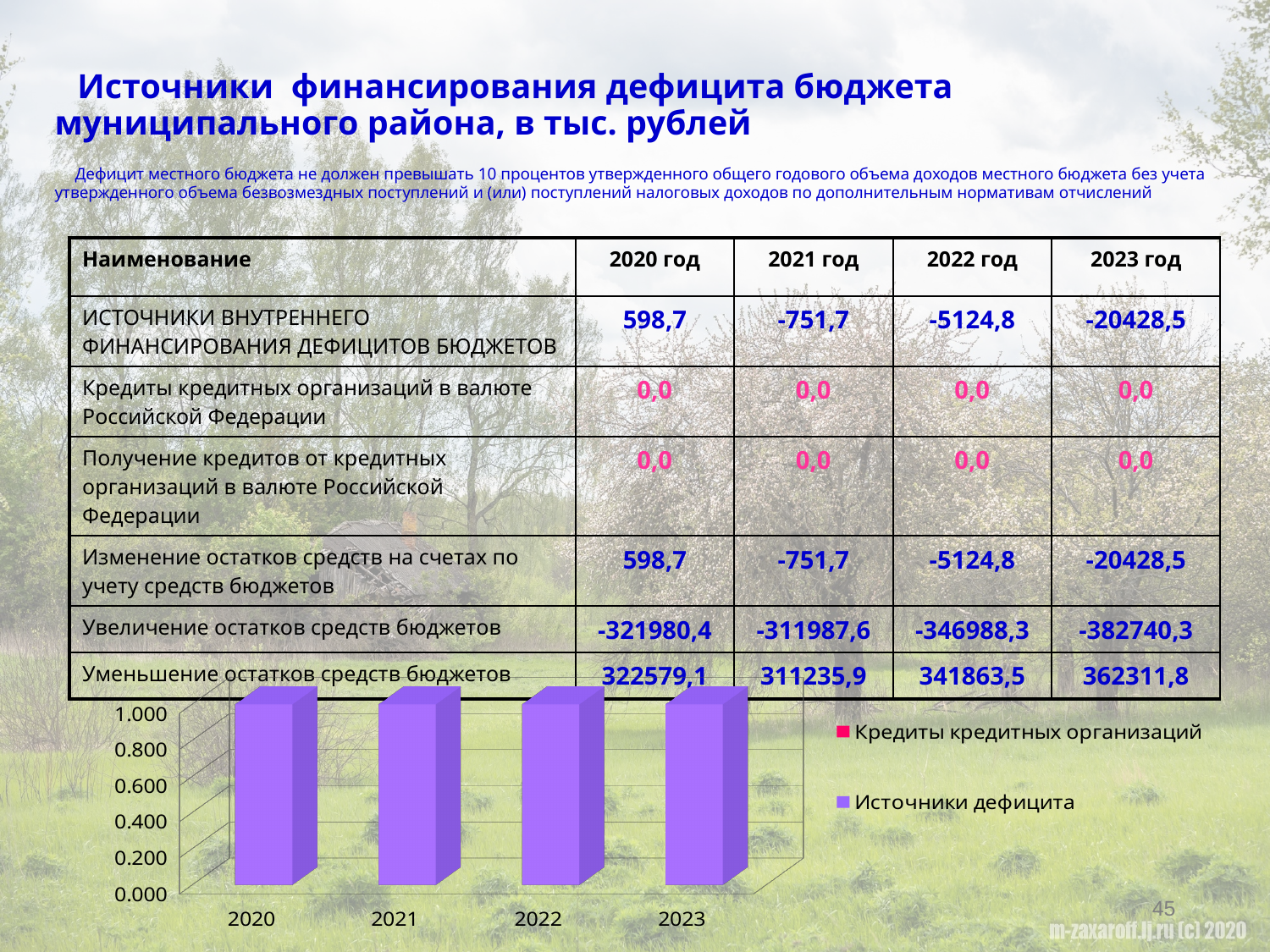
What are the two entries in the legend of the bar chart? Кредиты кредитных организаций and Источники дефицита How many years are shown on the x axis of the bar chart? 4 How many series does the legend of the bar chart list? 2 In the bar chart, is the value for 2023 greater or less than 0.600? greater Do the bar heights in the bar chart rise, fall, or stay the same from 2020 to 2023? stay the same In the bar chart, is the value for 2020 greater or less than 0.800? greater Which year is the first category on the x axis of the bar chart? 2020 In the bar chart, is the value for 2022 greater or less than 0.400? greater What colour are the bars for Источники дефицита in the bar chart? purple Which year is the last category on the x axis of the bar chart? 2023 What kind of chart is shown at the bottom of the slide? bar chart